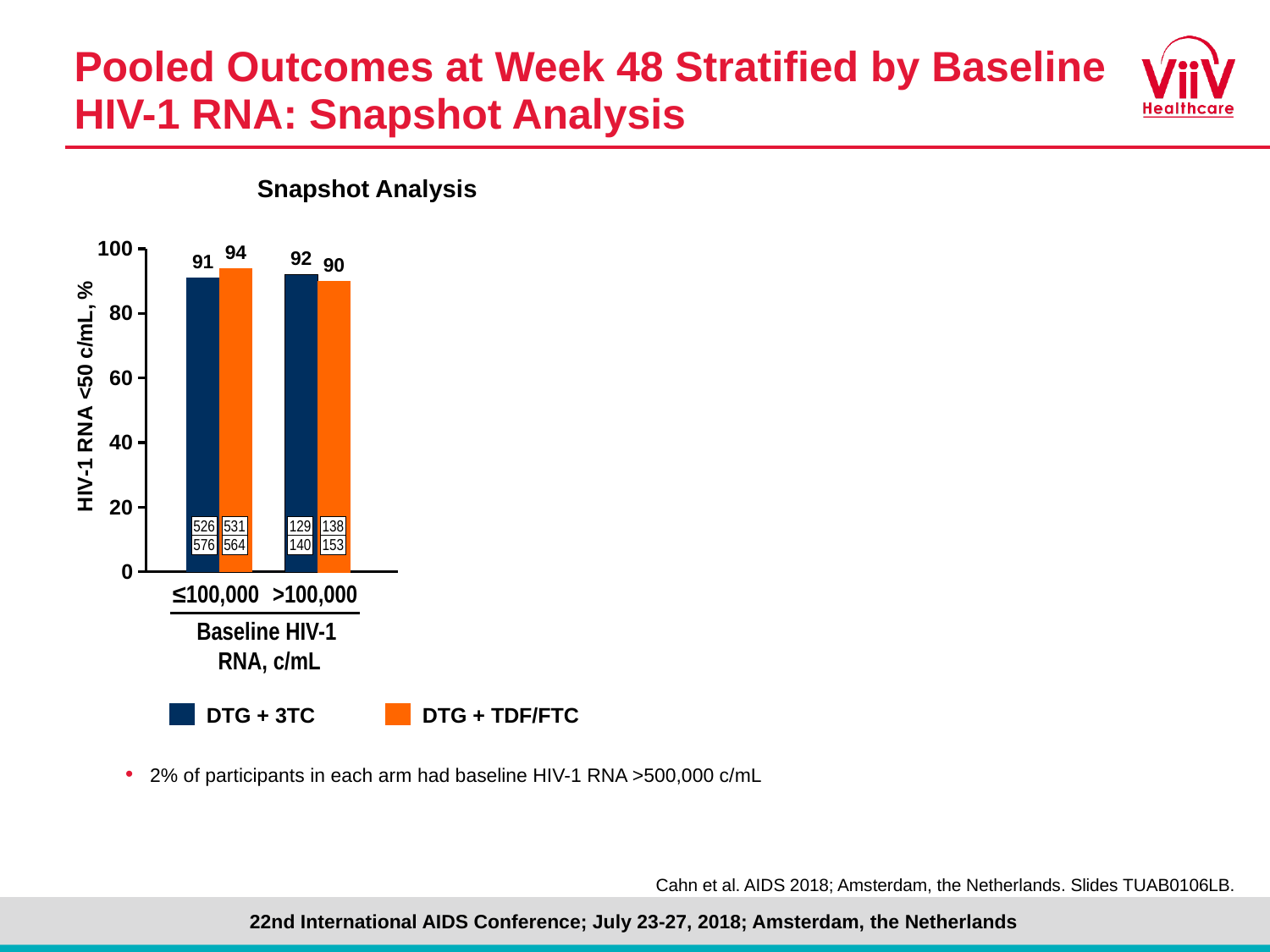
How many series does the legend list? 2 Which series has the higher value in the >100,000 group? DTG + 3TC What is the difference between DTG + 3TC and DTG + TDF/FTC in the >100,000 group? 2 What is the value for DTG + 3TC in the >100,000 baseline HIV-1 RNA group? 92 How many baseline HIV-1 RNA categories are shown on the x axis? 2 What is the label of the y axis? HIV-1 RNA <50 c/mL, % Which series has the higher value in the ≤100,000 group? DTG + TDF/FTC What is the value for DTG + TDF/FTC in the >100,000 baseline HIV-1 RNA group? 90 What kind of chart is shown on the slide? Bar chart What is the difference between DTG + TDF/FTC and DTG + 3TC in the ≤100,000 group? 3 What is the value for DTG + 3TC in the ≤100,000 baseline HIV-1 RNA group? 91 What is the value for DTG + TDF/FTC in the ≤100,000 baseline HIV-1 RNA group? 94